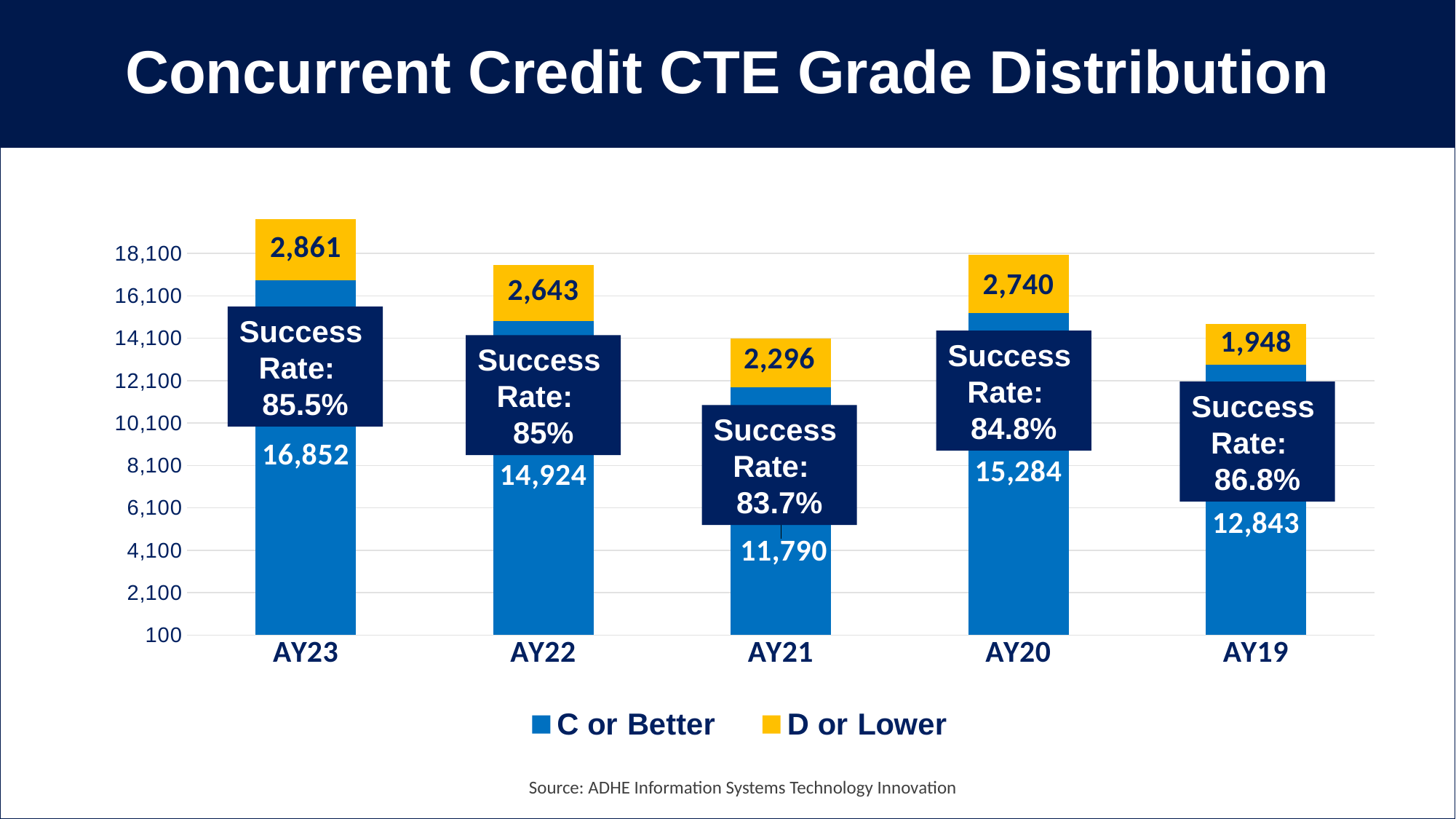
What success rate is shown for AY19? 86.8% How many series does the legend list? 2 What is the value for C or Better in AY23? 16,852 How many academic years are shown on the x axis? 5 What is the value for D or Lower in AY21? 2,296 Which colour represents the D or Lower series? Yellow Which is larger, the D or Lower value for AY20 or for AY22? AY20 Which academic year has the highest C or Better value? AY23 Which academic year has the lowest D or Lower value? AY19 What kind of chart is shown on the slide? Stacked bar chart What is the difference between the C or Better values for AY23 and AY22? 1,928 What is the total of the stacked bar for AY21? 14,086